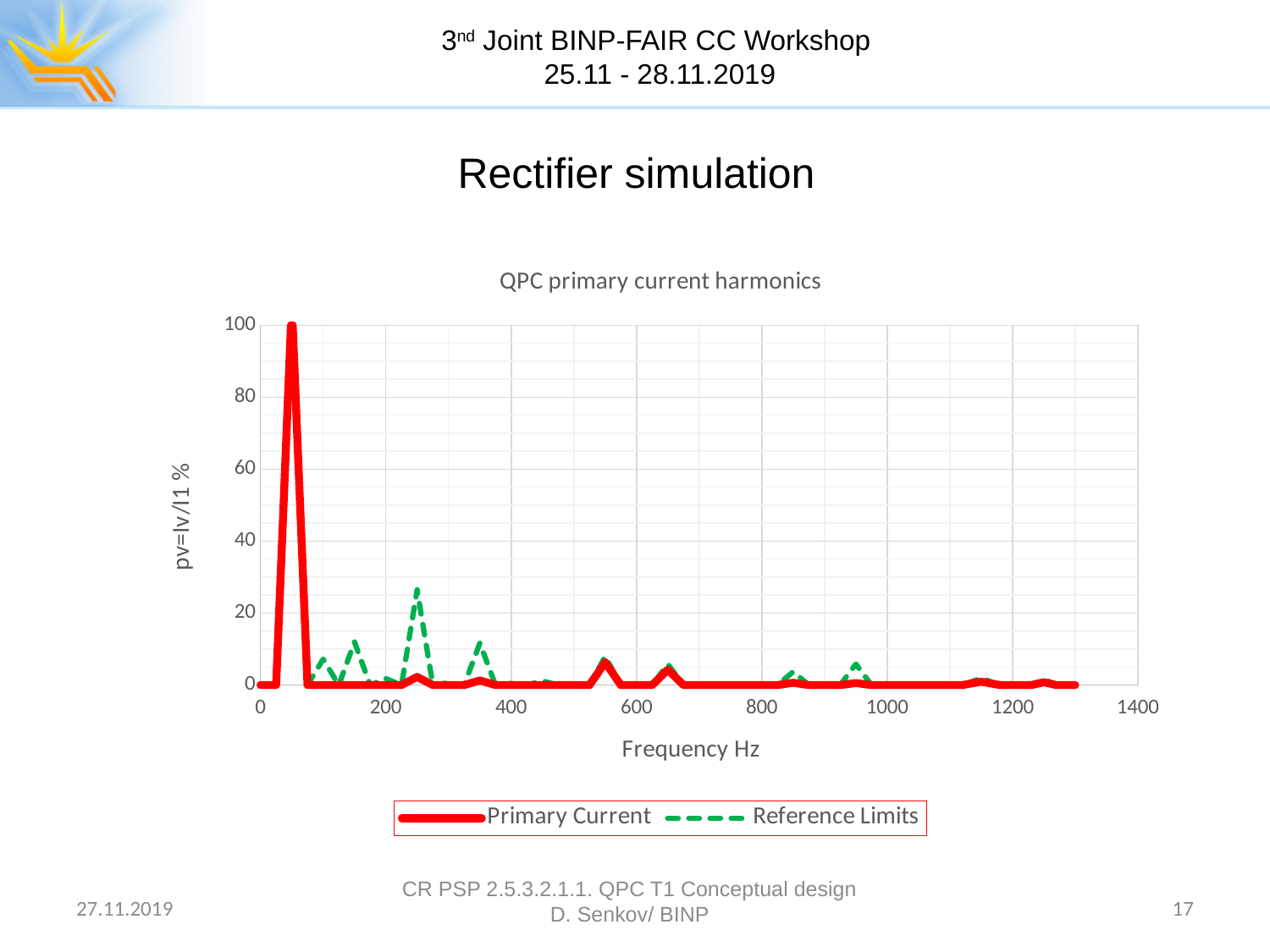
Is the Reference Limits value near 950 Hz greater or less than 40? less What kind of chart is shown on the slide? line chart How many series does the legend list? 2 Is the Primary Current peak near 550 Hz greater or less than 20? less Is the Reference Limits peak near 250 Hz greater or less than 20? greater What is the label of the x axis? Frequency Hz What is the title of the chart? QPC primary current harmonics Near 250 Hz, which series has the higher value, Primary Current or Reference Limits? Reference Limits